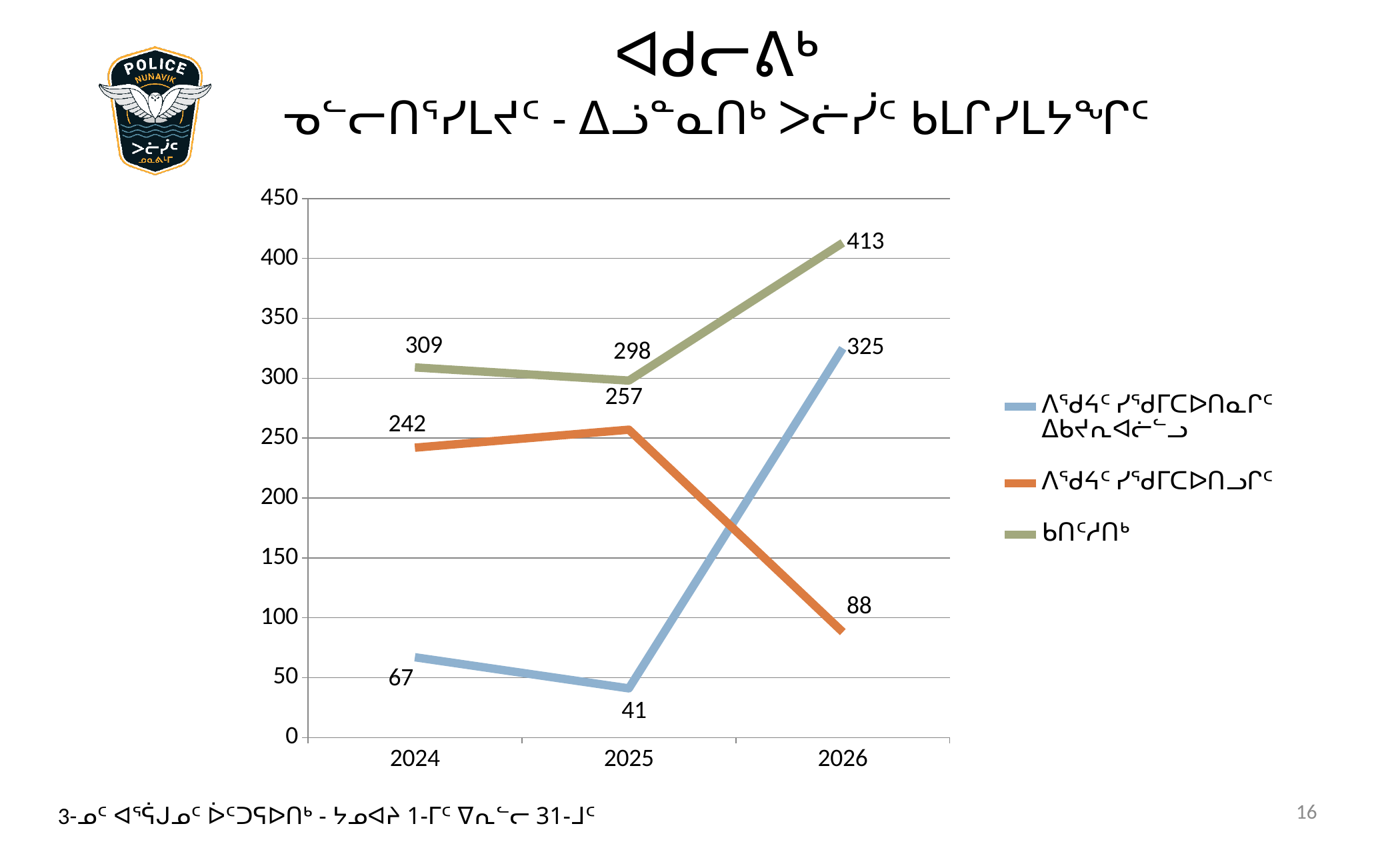
What is the value of the green line in 2026? 413 Does the orange line rise or fall from 2025 to 2026? fall By how much does the blue line increase from 2025 to 2026? 284 What is the value of the blue line in 2025? 41 How many years are plotted along the x axis of the chart? 3 What is the difference between the green line's 2026 value and its 2024 value? 104 What kind of chart is shown on the slide? line chart In which year does the green line reach its highest value? 2026 How many series does the chart's legend list? 3 What is the value of the orange line in 2024? 242 In which year does the blue line have its lowest value? 2025 In 2026, which is larger: the blue line or the orange line? the blue line